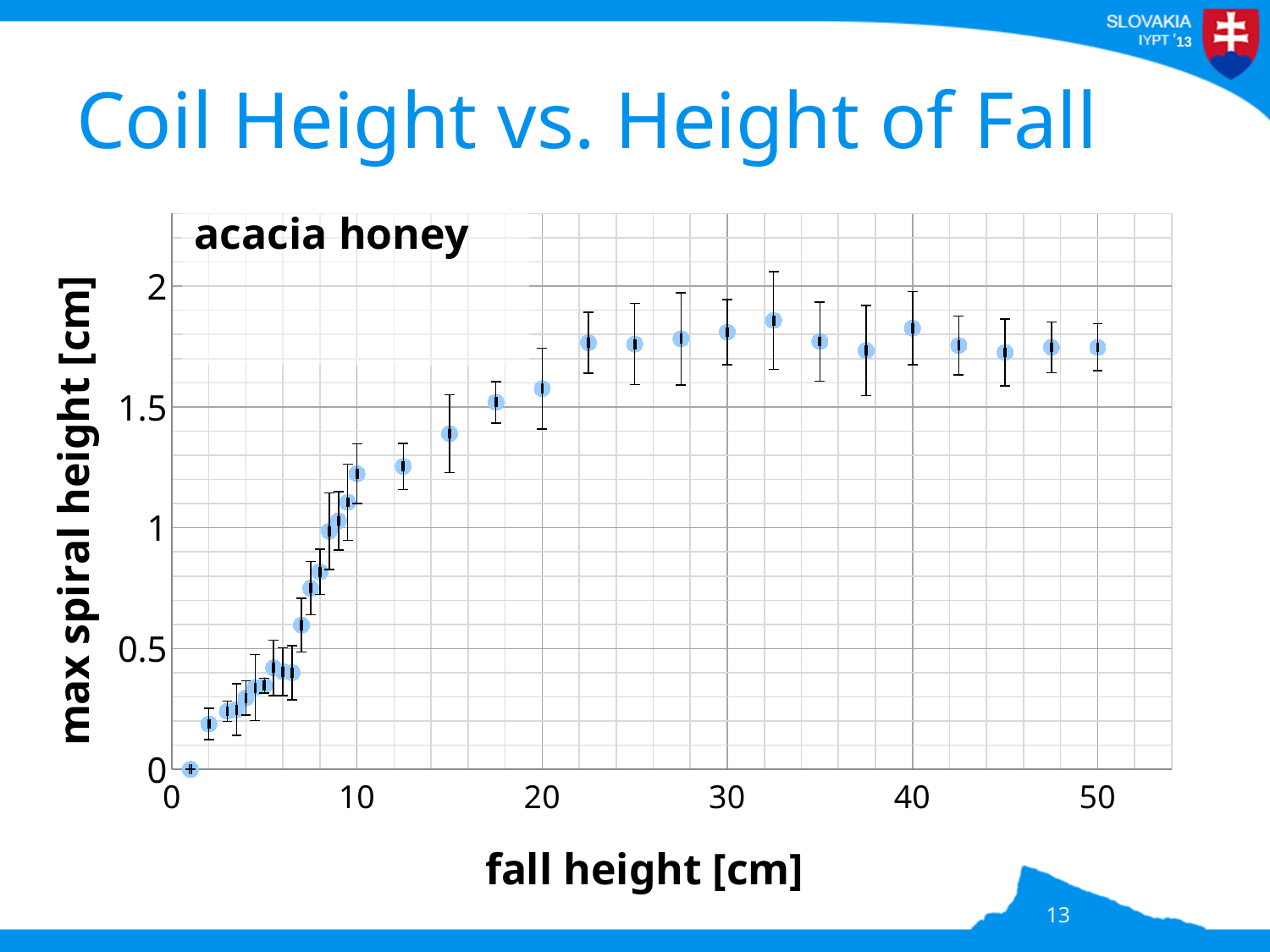
How does the max spiral height change as fall height increases from 0 to 50 cm? rises steeply up to about 20 cm, then levels off What label is written on the y axis of the chart? max spiral height [cm] Which has the larger max spiral height: a fall height of 5 cm or a fall height of 30 cm? 30 cm Is the max spiral height at a fall height of 20 cm greater or less than 1.5? greater Is the max spiral height at a fall height of 5 cm greater or less than 0.5? less What is the title of the slide's chart? Coil Height vs. Height of Fall What kind of chart is shown on the slide? scatter chart Is the max spiral height at a fall height of 30 cm greater or less than 1.5? greater Which has the larger max spiral height: a fall height of 10 cm or a fall height of 20 cm? 20 cm